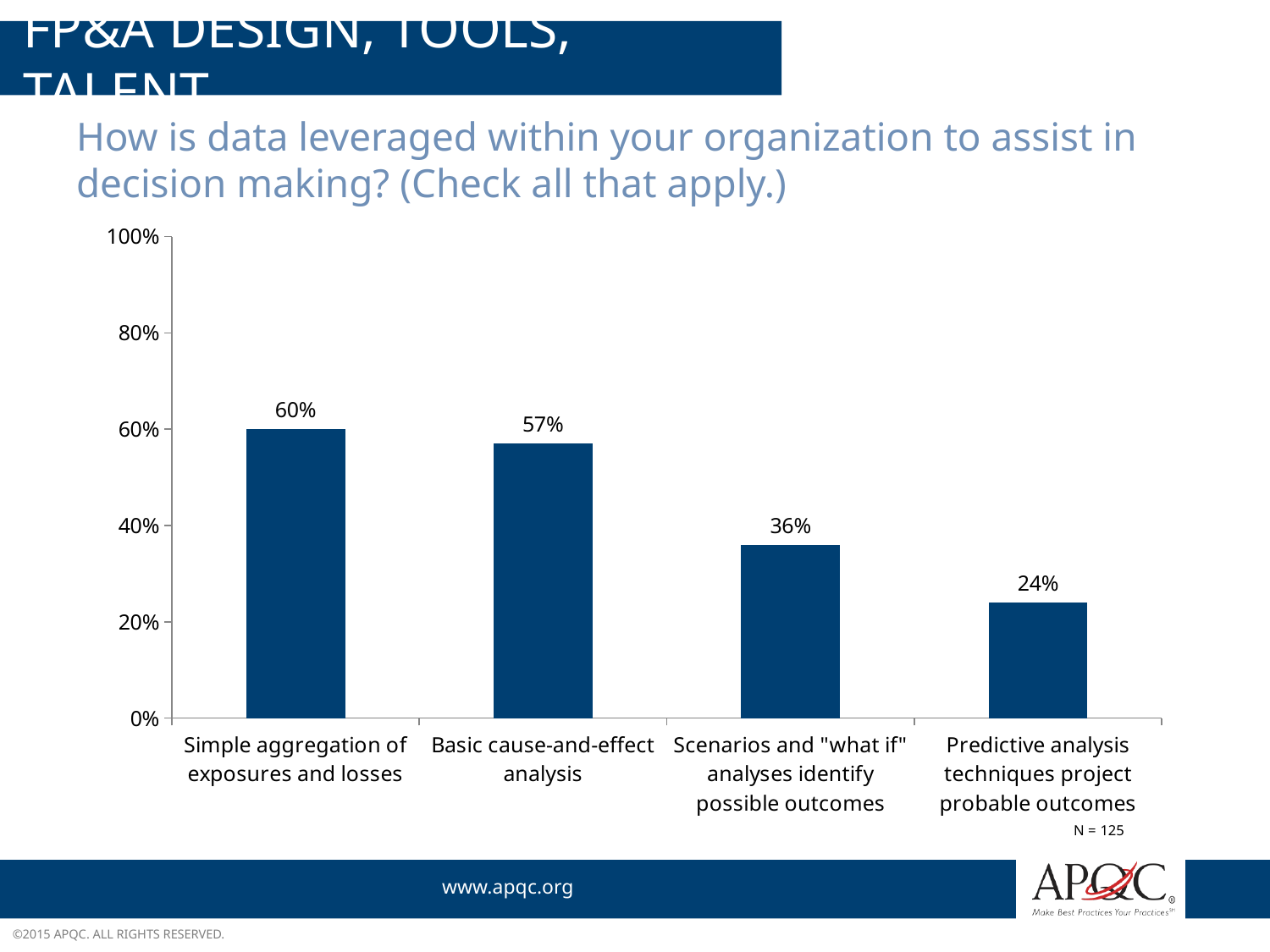
Which category has the lowest value? Predictive analysis techniques project probable outcomes What is the difference between the values for "Simple aggregation of exposures and losses" and "Predictive analysis techniques project probable outcomes"? 36% What percentage is shown for "Predictive analysis techniques project probable outcomes"? 24% Which category has the highest value? Simple aggregation of exposures and losses What percentage is shown for "Basic cause-and-effect analysis"? 57% How many categories are shown in the chart? 4 What percentage is shown for "Simple aggregation of exposures and losses"? 60% Do the values rise or fall from left to right across the categories? fall Which is larger: the value for "Basic cause-and-effect analysis" or the value for "Scenarios and "what if" analyses identify possible outcomes"? Basic cause-and-effect analysis What kind of chart is shown on the slide? bar chart Is the value for "Scenarios and "what if" analyses identify possible outcomes" greater or less than 40%? less What percentage is shown for "Scenarios and "what if" analyses identify possible outcomes"? 36%